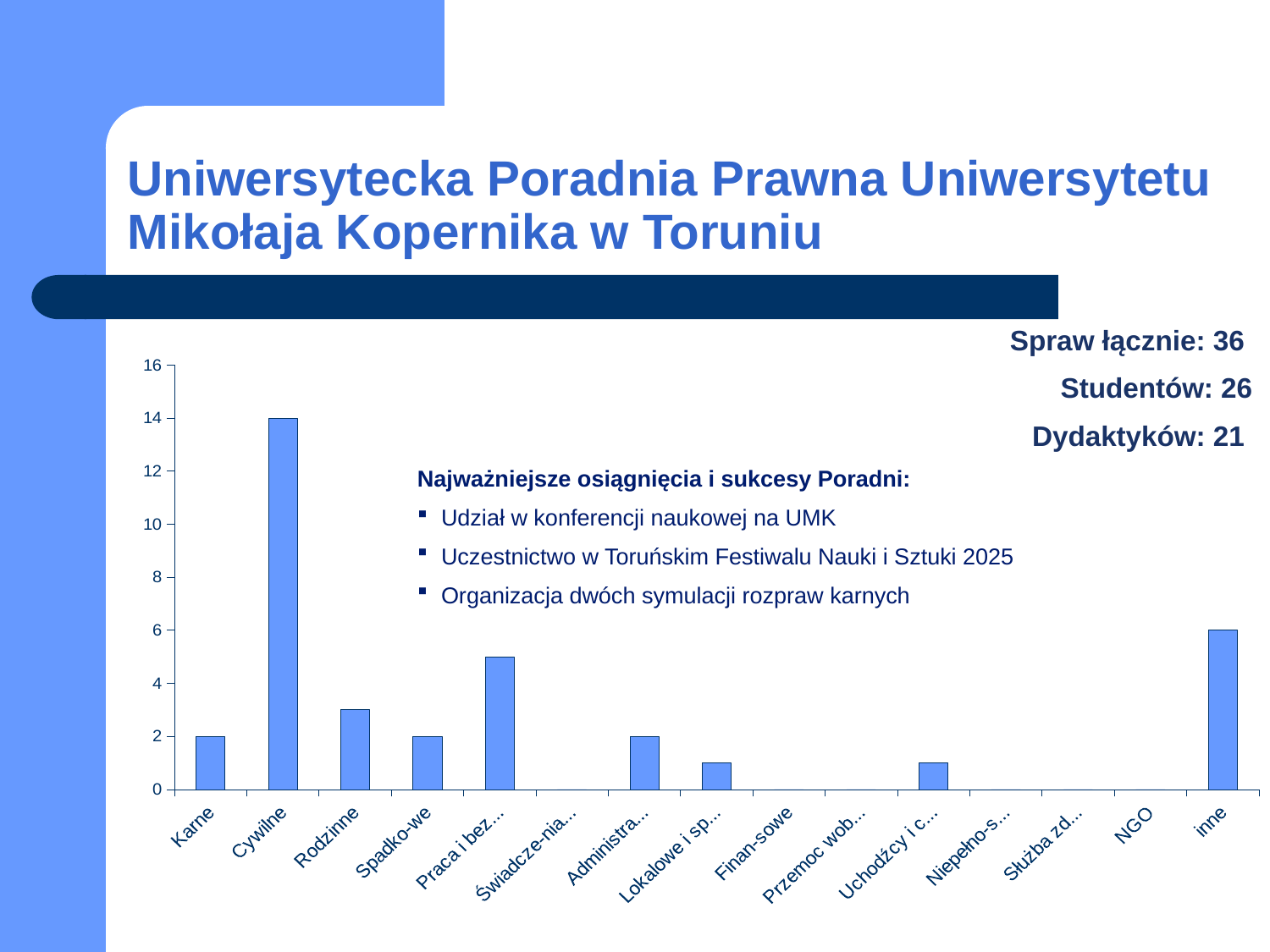
What is the difference between the values for Cywilne and inne? 8 Is the value for Praca i bez... greater or less than 4? greater What colour are the bars in the chart? blue Is the value for Rodzinne greater or less than 4? less What is the value for inne? 6 Which is larger, the value for Rodzinne or the value for Karne? Rodzinne Which category has the highest bar? Cywilne What is the value for Karne? 2 What is the value for Spadko-we? 2 What is the value for Cywilne? 14 How many categories are shown on the x axis? 15 What kind of chart is shown on the slide? bar chart